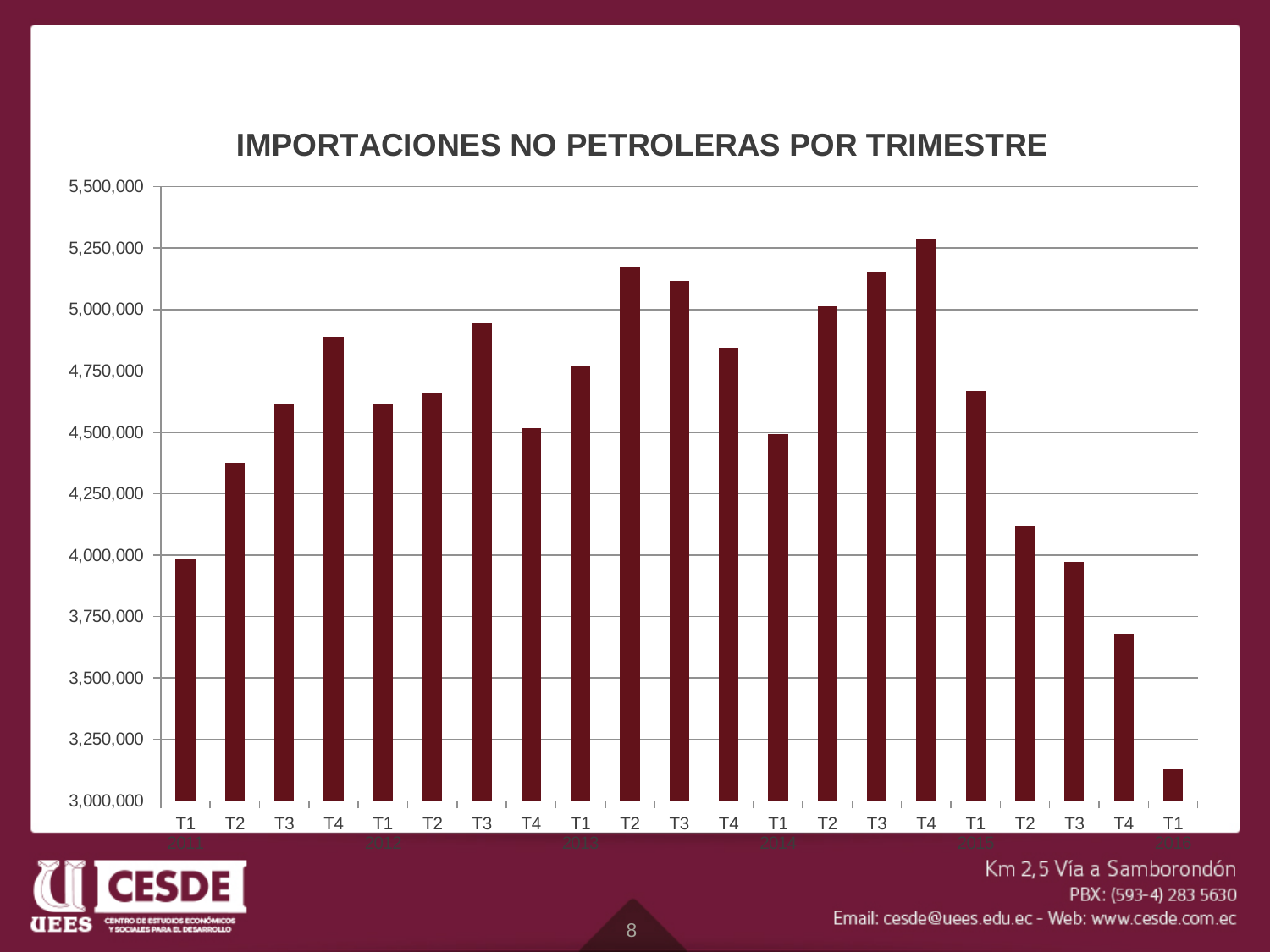
Which is larger, the value for T1 2014 or the value for T2 2014? T2 2014 What kind of chart is shown on the slide? bar chart Is the value for T4 2015 greater or less than 5,250,000? less Is the value for T2 2011 greater or less than 4,250,000? greater Which quarter has the highest value in the chart? T4 2014 Do the values rise or fall from T1 2015 to T1 2016? fall Which is larger, the value for T2 2015 or the value for T3 2015? T2 2015 How many bars (quarters) are plotted in the chart? 21 What is the title of the chart? IMPORTACIONES NO PETROLERAS POR TRIMESTRE Is the value for T4 2014 greater or less than 5,000,000? greater Which quarter has the lowest value in the chart? T1 2016